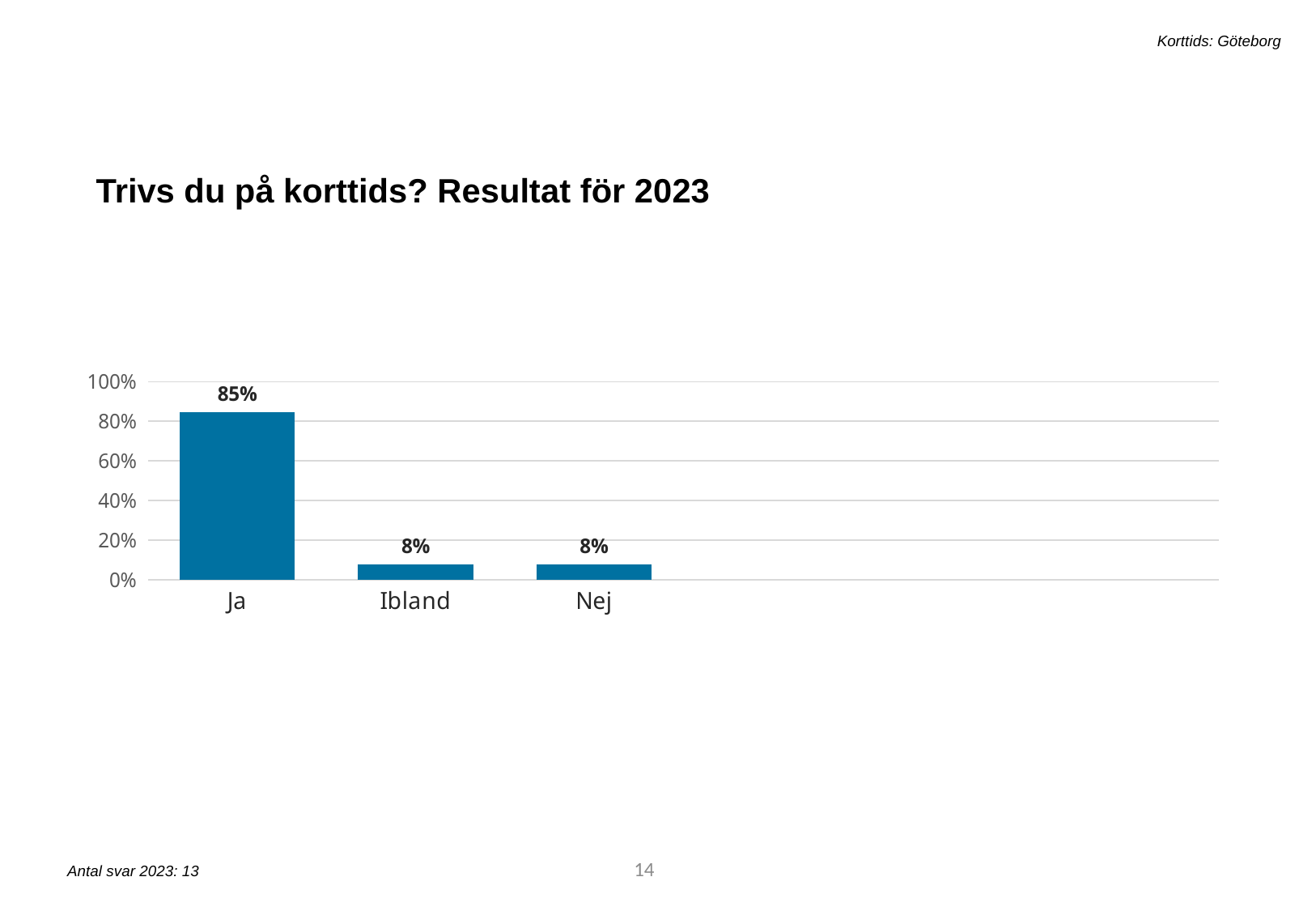
How many categories are shown on the x axis? 3 Which category has the highest value? Ja What is the value for Ibland? 8% What is the value for Ja? 85% Which is larger, the value for Ja or the value for Ibland? Ja Is the value for Nej greater or less than 20%? less What is the value for Nej? 8% What is the difference between the values for Ja and Ibland? 77% Is the value for Ja greater or less than 60%? greater What is the difference between the values for Ja and Nej? 77% What kind of chart is shown on the slide? bar chart What is the title of the slide above the chart? Trivs du på korttids? Resultat för 2023